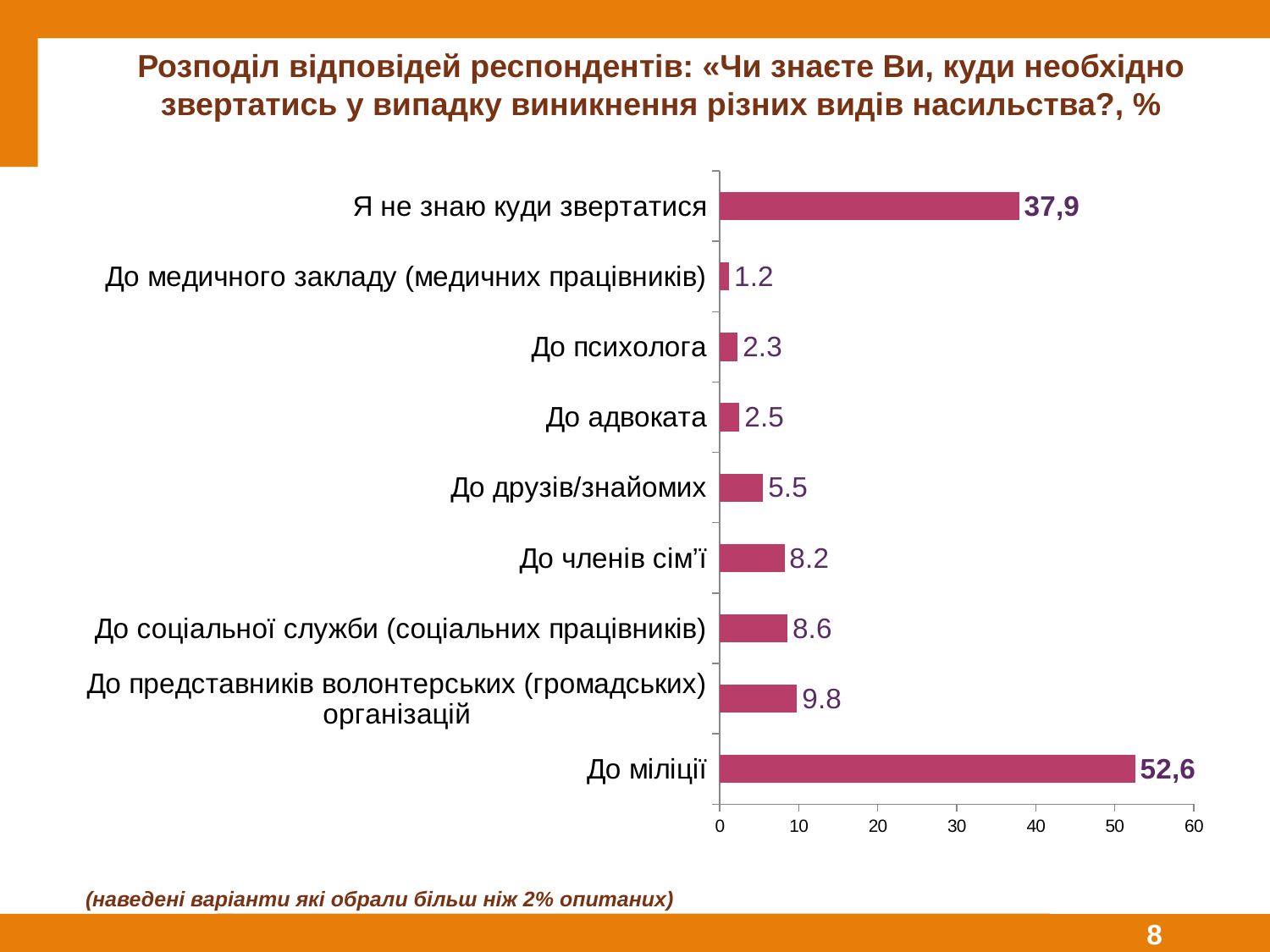
What is the value for «До міліції»? 52,6 Which category has the highest value? До міліції What is the difference between the values for «До міліції» and «Я не знаю куди звертатися»? 14.7 What is the value for «До представників волонтерських (громадських) організацій»? 9.8 How many categories are shown in the chart? 9 What kind of chart is shown on the slide? bar chart What is the value for «До членів сім'ї»? 8.2 Which category has the lowest value? До медичного закладу (медичних працівників) Is the value for «До міліції» greater or less than 50? greater Which is larger: the value for «До друзів/знайомих» or the value for «До психолога»? До друзів/знайомих What is the maximum value shown on the horizontal axis? 60 What is the value for «Я не знаю куди звертатися»? 37,9